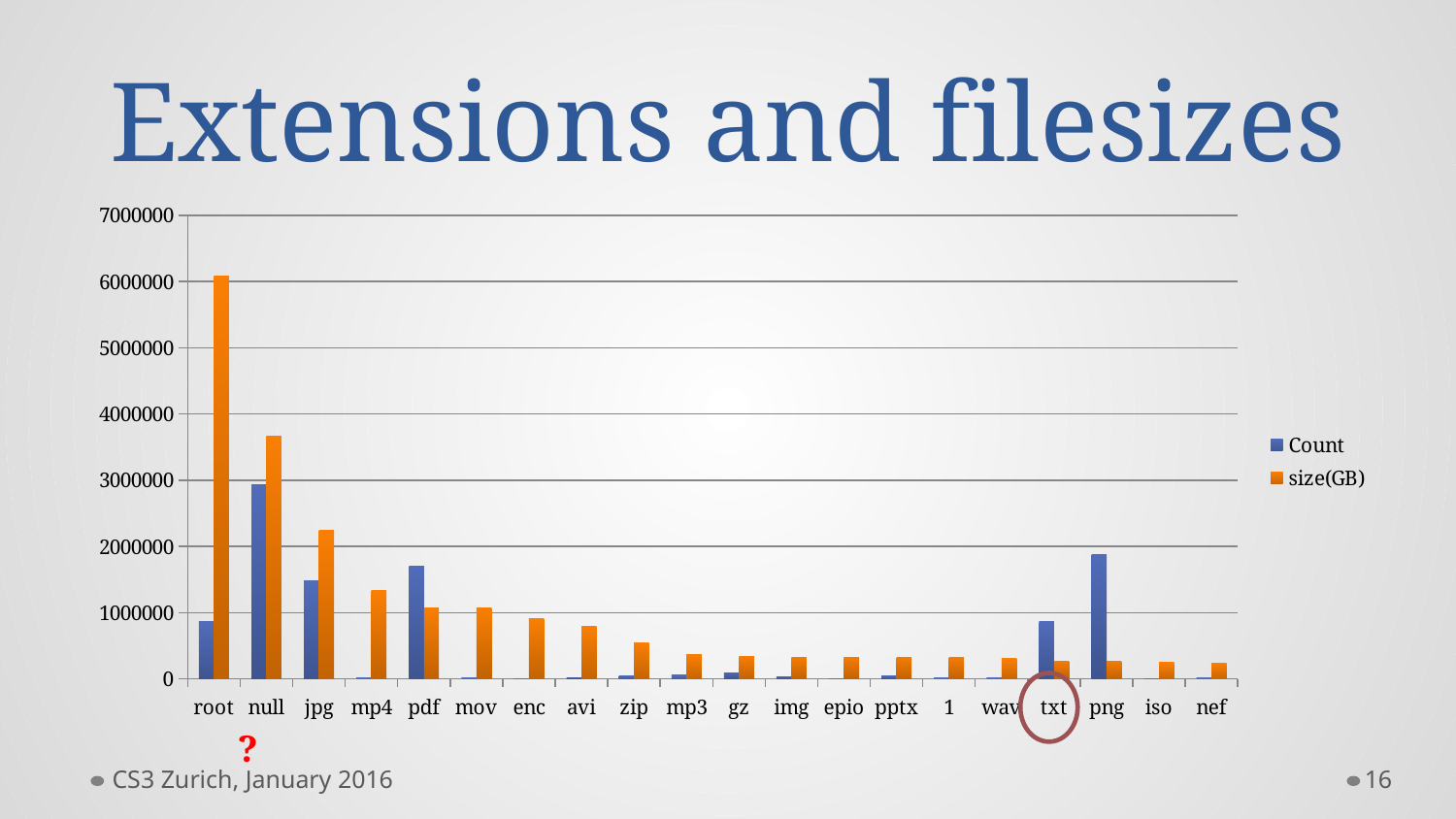
For root, which is larger: Count or size(GB)? size(GB) Which category has the highest size(GB) value? root Is the size(GB) value for root greater or less than 5000000? greater Which category has the highest Count value? null Which category on the x axis is circled? txt Is the size(GB) value for mp4 greater or less than 2000000? less How many series does the legend list? 2 For png, which is larger: Count or size(GB)? Count Is the Count value for null greater or less than 2000000? greater How many categories are shown on the x axis? 20 What type of chart is shown on the slide? bar chart